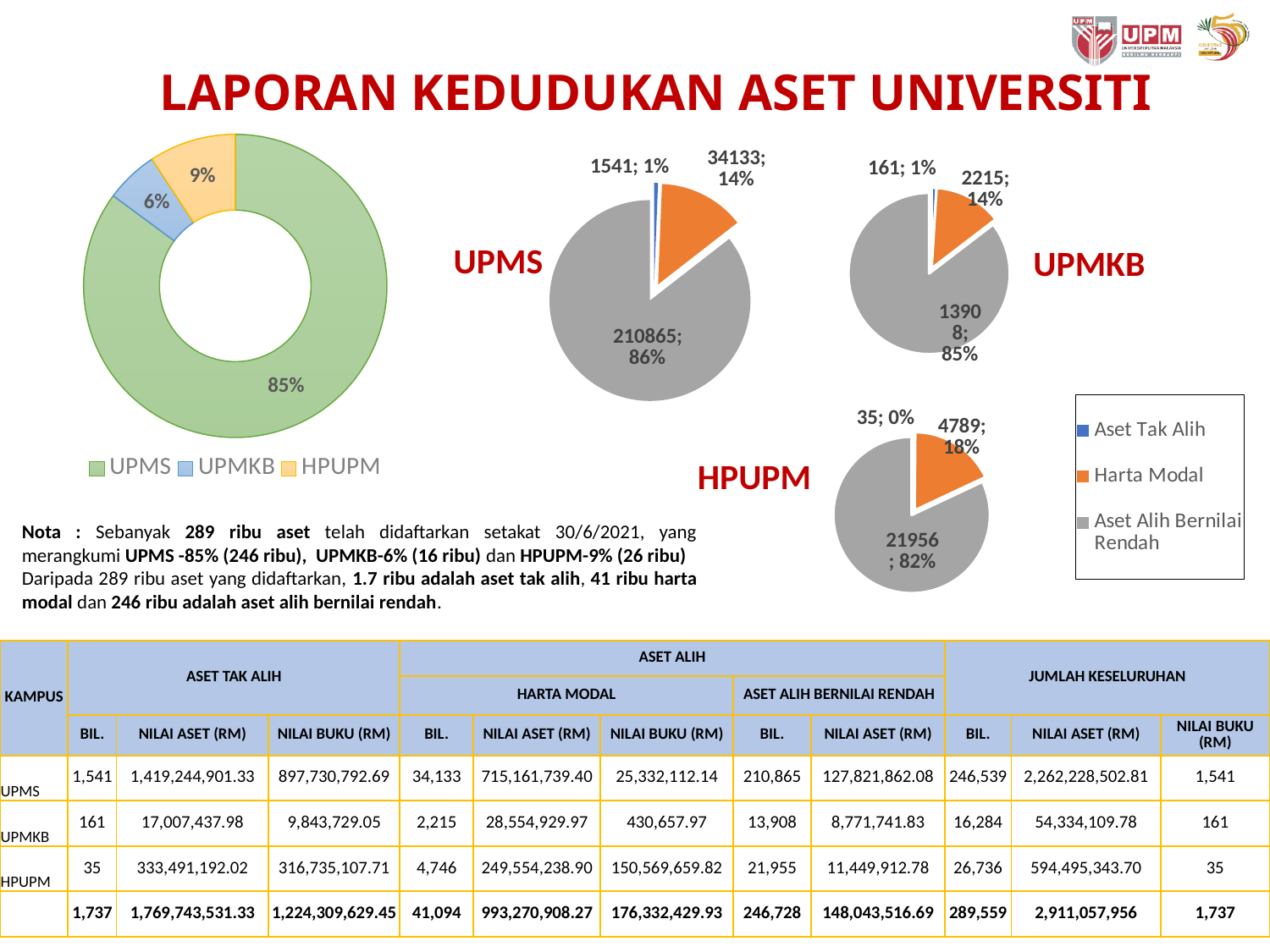
How many categories does the legend of the donut chart on the left list? 3 In the HPUPM pie chart, what percentage is shown for the Harta Modal slice? 18% In the donut chart on the left, which campus has the smallest share? UPMKB In the donut chart on the left, what share does HPUPM have? 9% In the UPMS pie chart, what percentage is shown for the Aset Tak Alih slice? 1% In the HPUPM pie chart, which slice is the largest? Aset Alih Bernilai Rendah In the UPMS pie chart, what is the value labelled for the Harta Modal slice? 34133; 14% In the UPMS pie chart, what is the value labelled for the Aset Alih Bernilai Rendah slice? 210865; 86% In the HPUPM pie chart, what is the value labelled for the Aset Alih Bernilai Rendah slice? 21956; 82% What type of chart is the UPMKB chart? Pie chart In the UPMKB pie chart, what is the value labelled for the Harta Modal slice? 2215; 14%